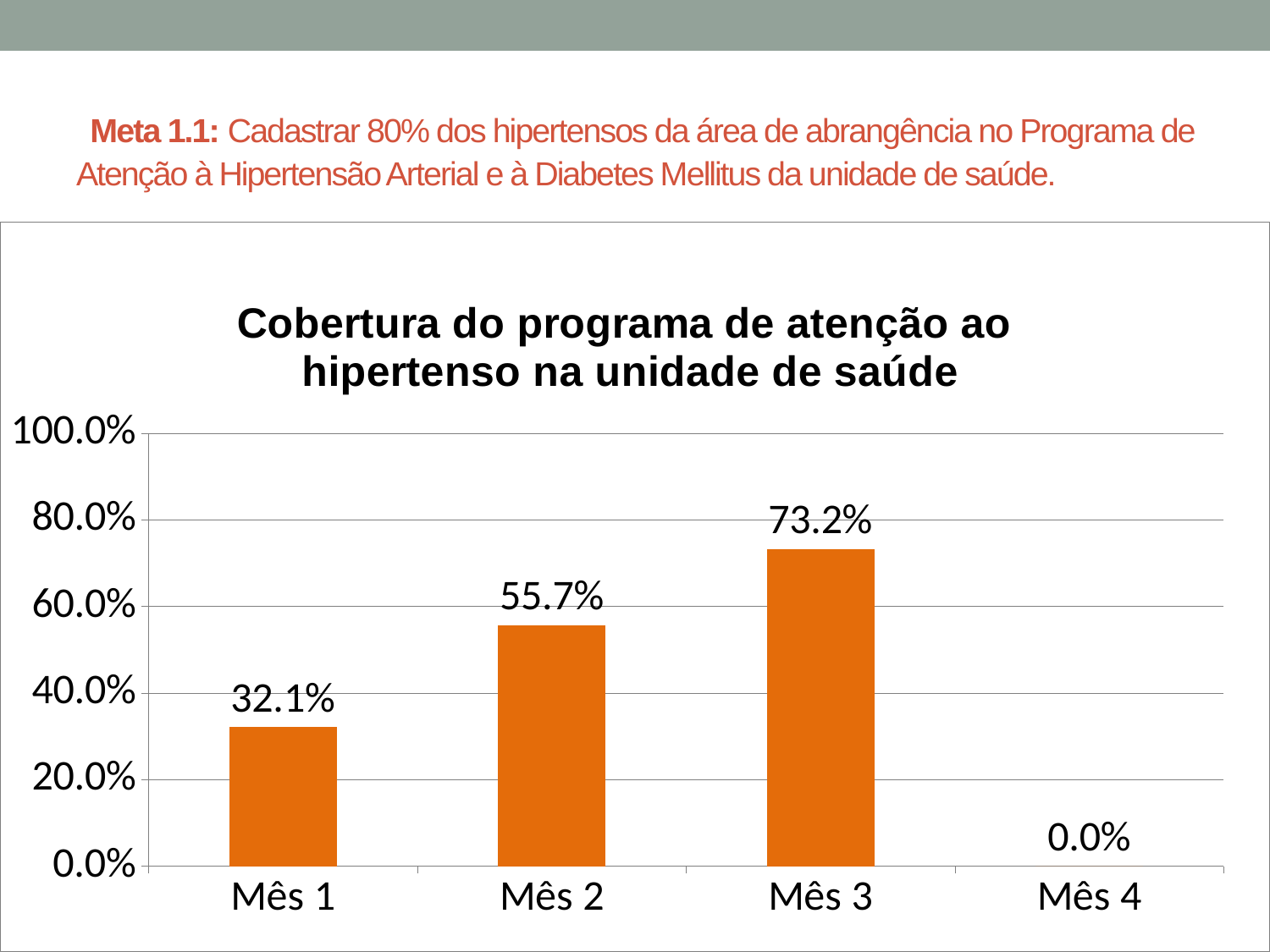
Is the value for Mês 3 greater or less than 80.0%? less What is the difference between the values for Mês 2 and Mês 1? 23.6% Which is larger, the value for Mês 1 or the value for Mês 2? Mês 2 What is the value for Mês 1? 32.1% What is the value for Mês 4? 0.0% What is the value for Mês 2? 55.7% How many months are shown on the x axis? 4 What is the value for Mês 3? 73.2% What kind of chart is shown? bar chart Which month has the lowest value? Mês 4 What is the difference between the values for Mês 3 and Mês 2? 17.5% Which month has the highest value? Mês 3